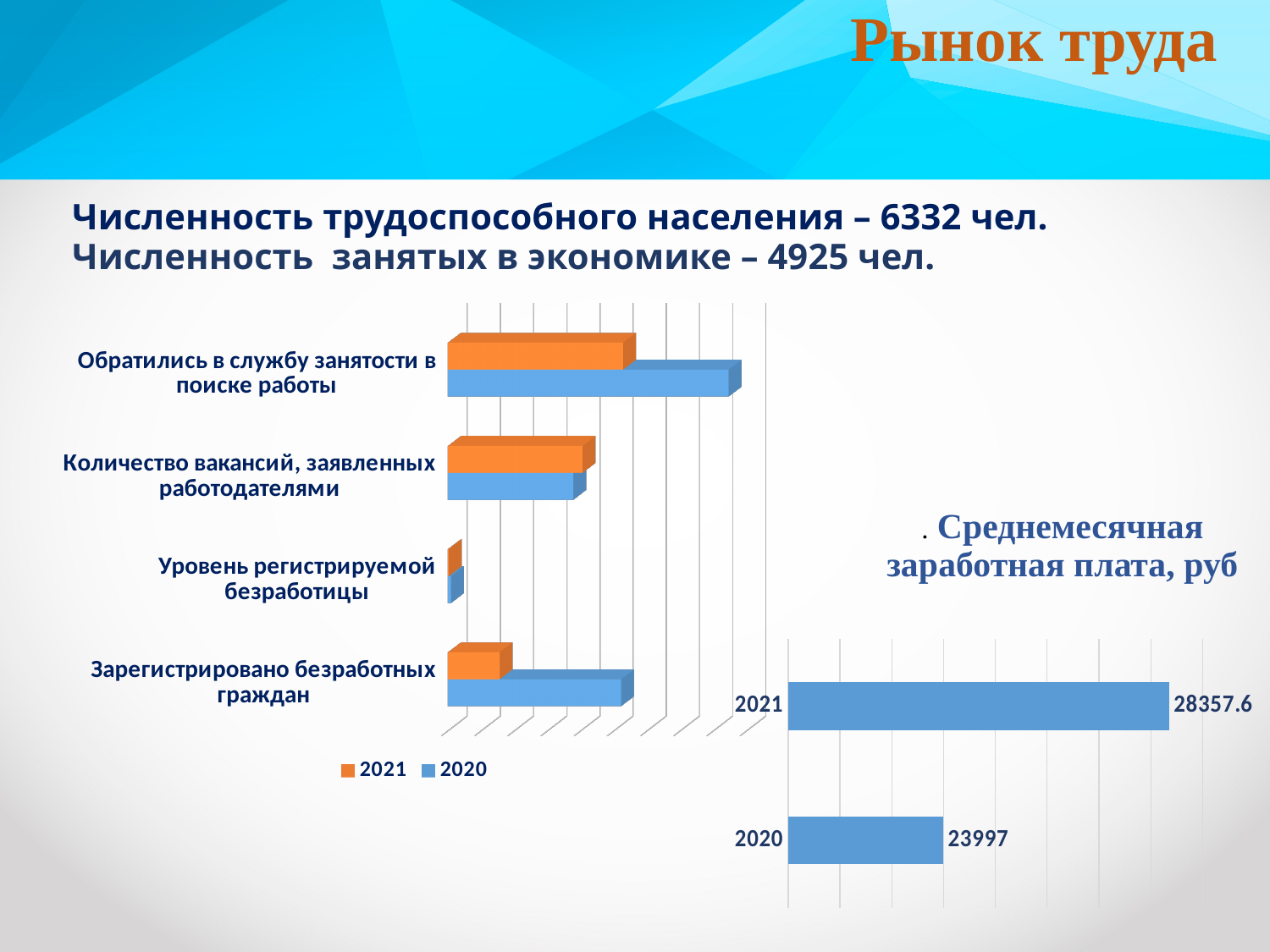
On the chart titled 'Среднемесячная заработная плата, руб', what is the value for 2021? 28357.6 On the chart titled 'Среднемесячная заработная плата, руб', what is the value for 2020? 23997 On the left chart, which colour represents the 2021 series? Orange On the chart titled 'Среднемесячная заработная плата, руб', what is the difference between the 2021 and 2020 values? 4360.6 On the left chart, which category has the longest 2020 bar? Обратились в службу занятости в поиске работы On the left chart, how many categories are shown? 4 What kind of chart is the one titled 'Среднемесячная заработная плата, руб'? Bar chart On the chart titled 'Среднемесячная заработная плата, руб', which year has the higher value, 2021 or 2020? 2021 On the left chart, how many series does the legend list? 2 On the left chart, for 'Зарегистрировано безработных граждан', which year has the larger value, 2021 or 2020? 2020 On the chart titled 'Среднемесячная заработная плата, руб', how many bars are plotted? 2 On the left chart, which category has the shortest bars? Уровень регистрируемой безработицы